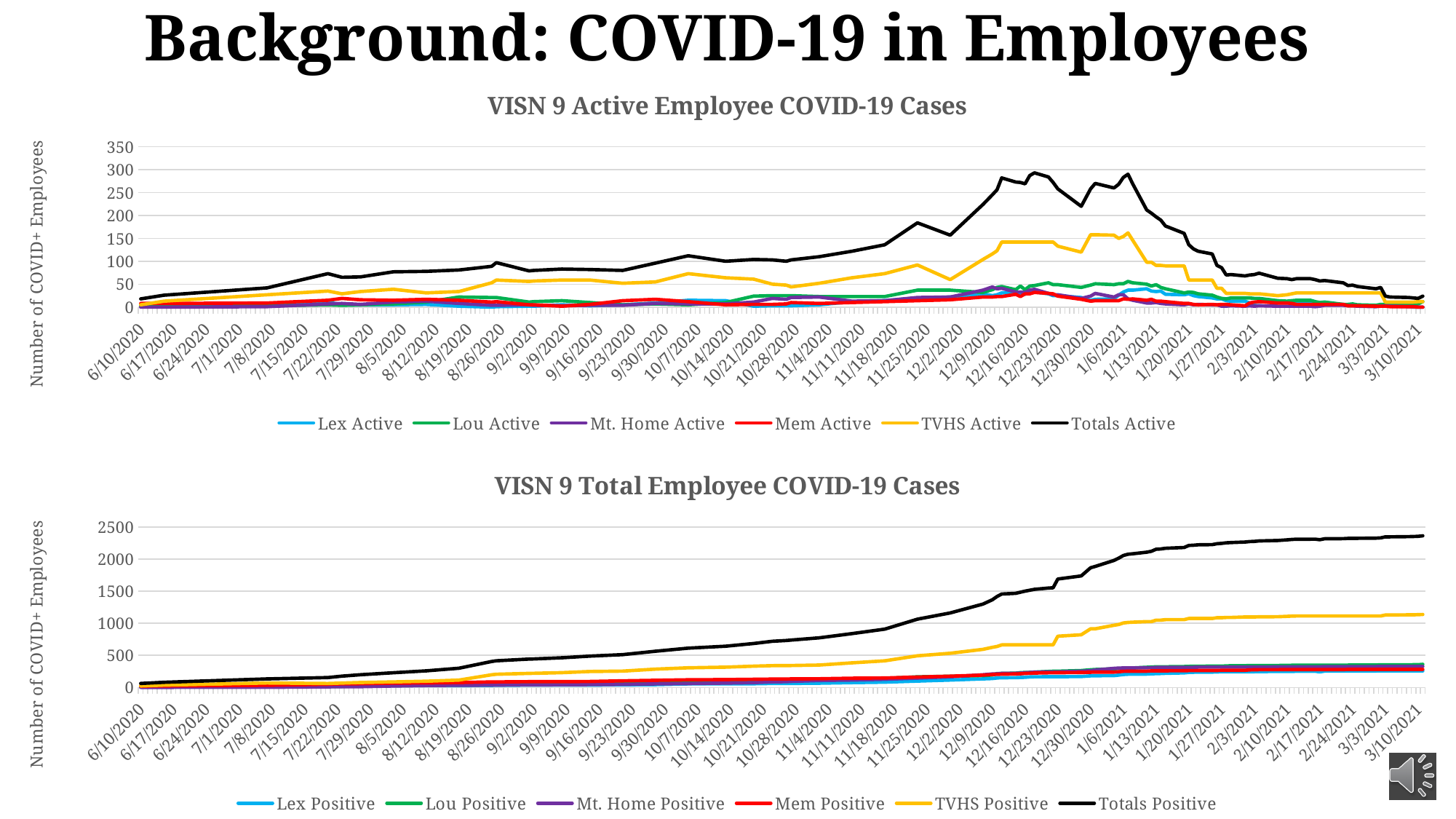
In the "VISN 9 Active Employee COVID-19 Cases" chart, is the value for Totals Active on 12/16/2020 greater or less than 250? greater In the "VISN 9 Total Employee COVID-19 Cases" chart, do the Totals Positive values rise or fall from 6/10/2020 to 3/10/2021? rise In the "VISN 9 Total Employee COVID-19 Cases" chart, is the value for Totals Positive on 3/10/2021 greater or less than 2000? greater In the "VISN 9 Active Employee COVID-19 Cases" chart, is the value for TVHS Active on 1/6/2021 greater or less than 100? greater In the "VISN 9 Total Employee COVID-19 Cases" chart, which series has the highest value on 3/10/2021? Totals Positive In the "VISN 9 Active Employee COVID-19 Cases" chart, which series is drawn in black? Totals Active In the "VISN 9 Total Employee COVID-19 Cases" chart, which is larger on 3/10/2021: TVHS Positive or Lex Positive? TVHS Positive What kind of chart is the "VISN 9 Active Employee COVID-19 Cases" chart? line chart What is the y-axis title of the "VISN 9 Total Employee COVID-19 Cases" chart? Number of COVID+ Employees How many series does the legend of the "VISN 9 Total Employee COVID-19 Cases" chart list? 6